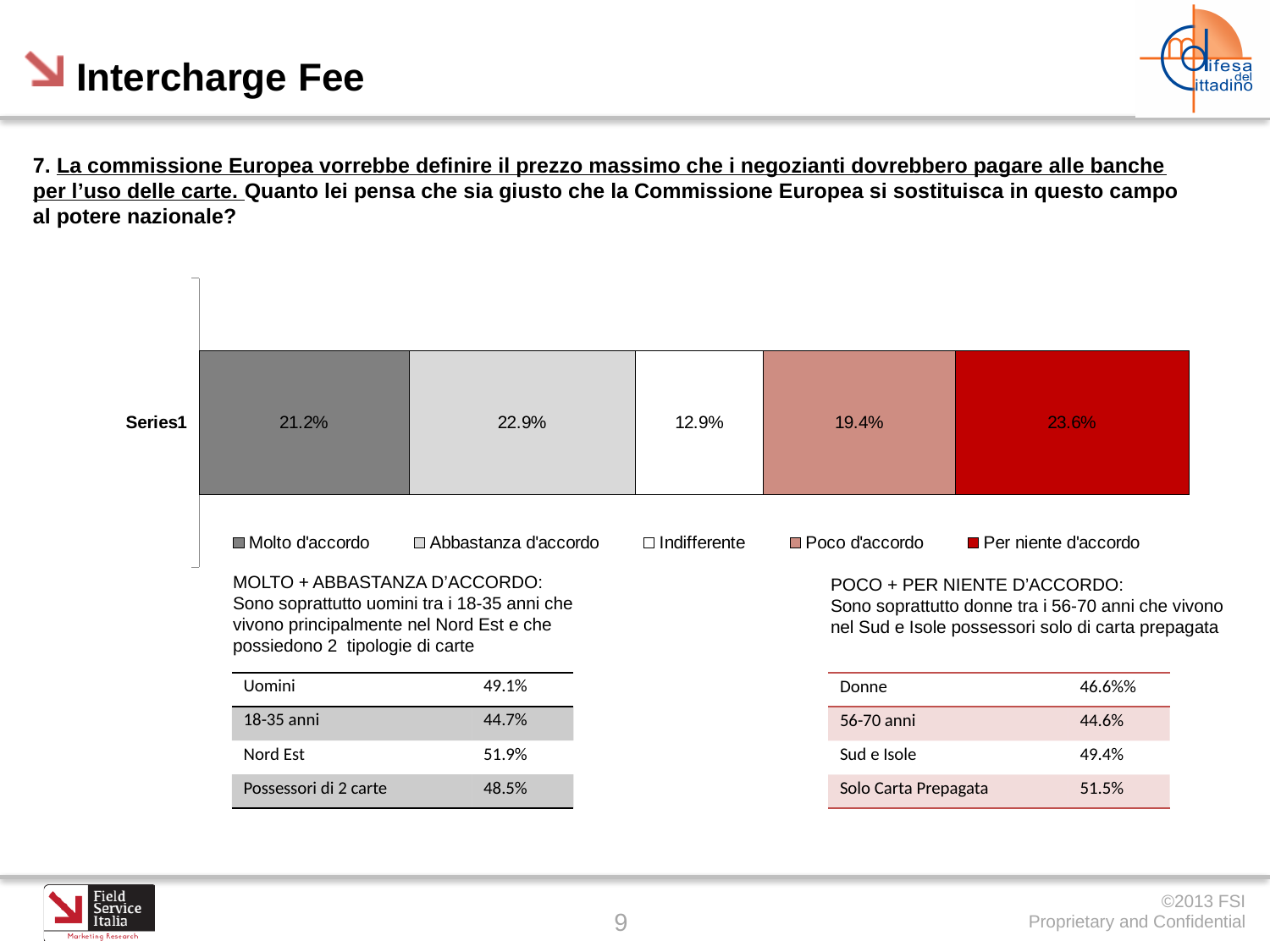
What is the value for Poco d'accordo? 19.4% Which series has the lowest value in the bar? Indifferente What is the difference between Abbastanza d'accordo and Molto d'accordo? 1.7% What is the value for Abbastanza d'accordo? 22.9% What is the value for Molto d'accordo? 21.2% What is the value for Per niente d'accordo? 23.6% Which series has the highest value in the bar? Per niente d'accordo What kind of chart is shown on the slide? stacked bar chart What is the value for Indifferente? 12.9% Which is larger, Poco d'accordo or Per niente d'accordo? Per niente d'accordo How many series does the chart legend list? 5 What is the label of the single category on the vertical axis? Series1